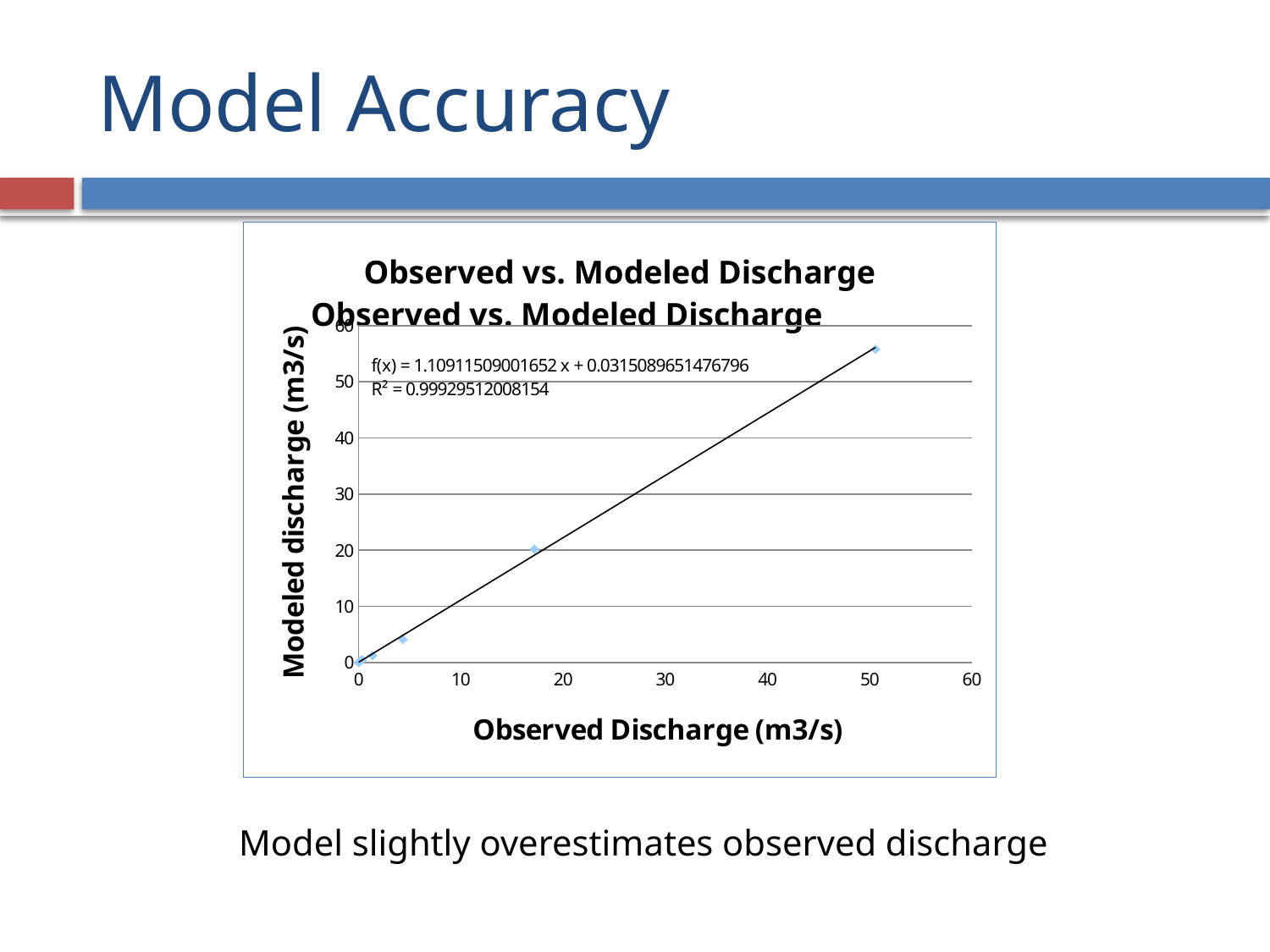
Is the modeled discharge for the point with the highest observed discharge greater or less than 50? greater Is the modeled discharge for the point near an observed discharge of 17 greater or less than 30? less What is the intercept of the trendline equation printed on the chart? 0.0315089651476796 What R² value is printed on the chart? R² = 0.99929512008154 What is the label of the x axis? Observed Discharge (m3/s) What is the highest value shown on the y axis? 60 What is the slope of the trendline equation printed on the chart? 1.10911509001652 What is the title of the chart? Observed vs. Modeled Discharge Do the modeled discharge values rise or fall as observed discharge increases along the x axis? Rise What kind of chart is shown on the slide? Scatter chart